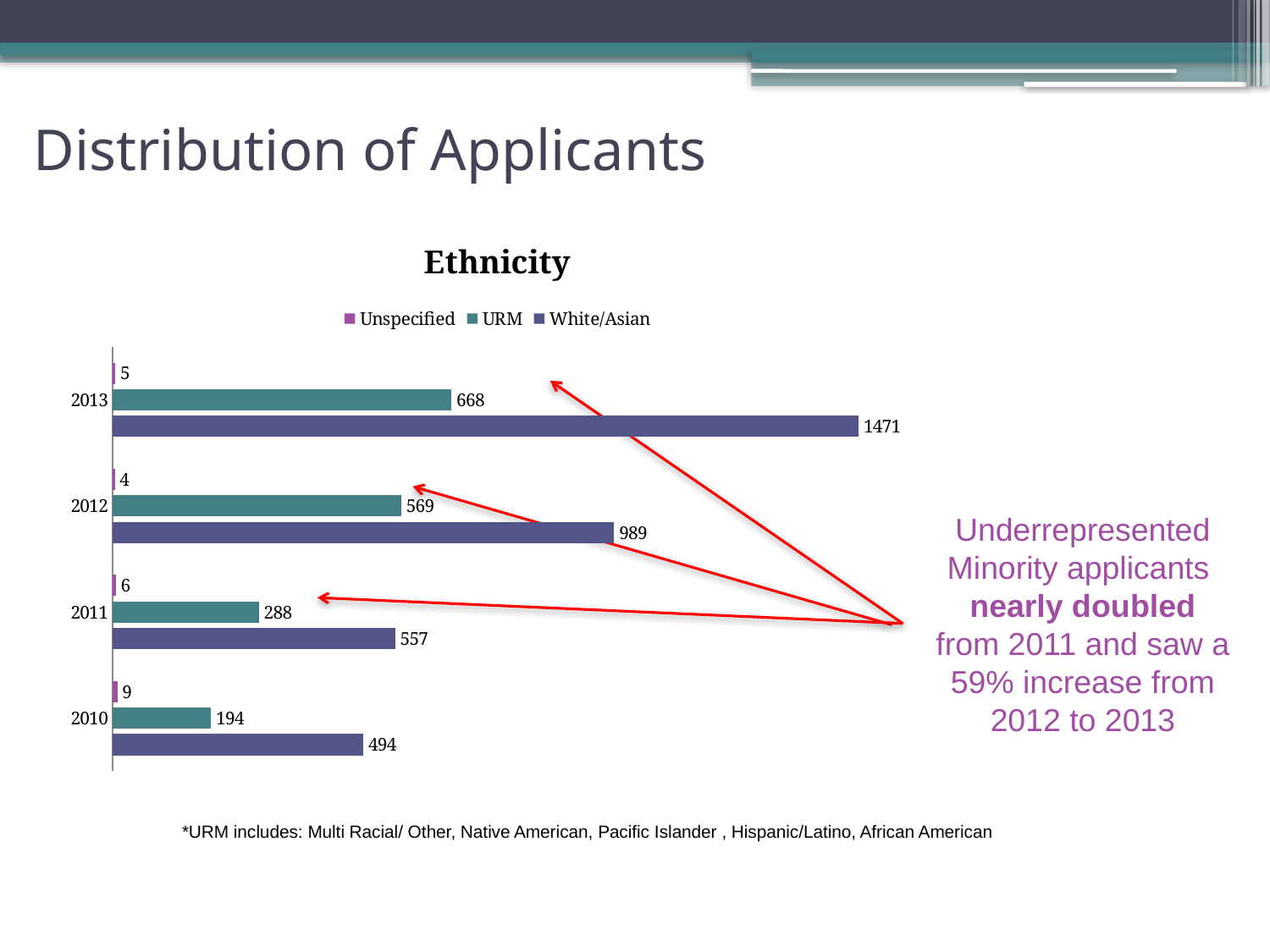
How many series does the legend list? 3 Which is larger, the White/Asian value for 2012 or the White/Asian value for 2011? 2012 What is the White/Asian value for 2010? 494 What is the difference between the URM values for 2013 and 2012? 99 What is the URM value for 2013? 668 What kind of chart is shown? bar chart How many years are shown on the chart? 4 What is the Unspecified value for 2011? 6 Which year has the lowest URM value? 2010 What is the title of the chart? Ethnicity Do the URM values rise or fall from 2010 to 2013? rise Which year has the highest White/Asian value? 2013